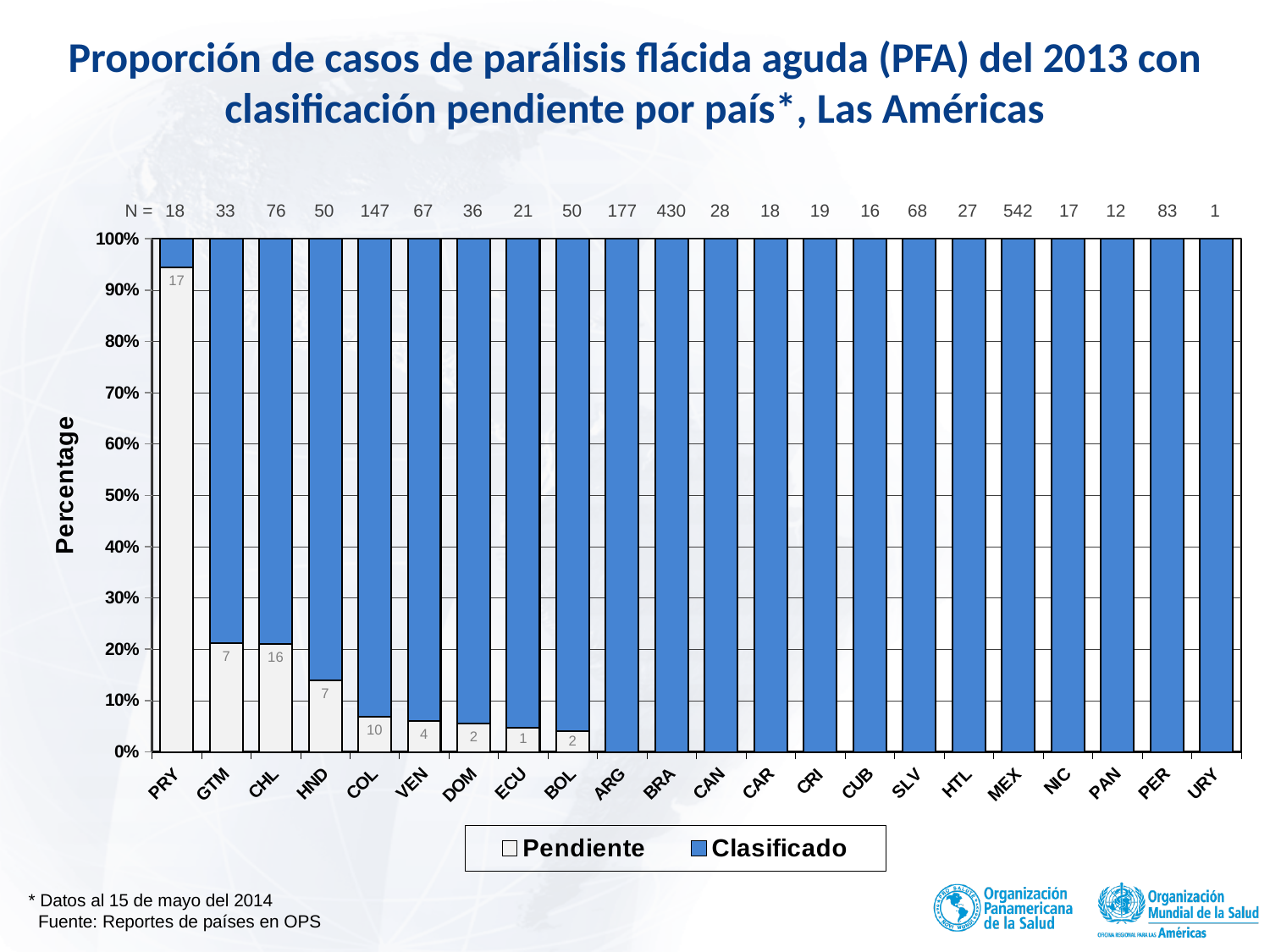
What is the N value shown above the bar for MEX? 542 How many series does the legend list? 2 What is the N value shown above the bar for BRA? 430 What kind of chart is shown on the slide? stacked bar chart What number is printed on the Pendiente segment for CHL? 16 Which series is shown in blue in the legend? Clasificado What number is printed on the Pendiente segment for PRY? 17 Which country has the largest Pendiente share of its bar? PRY Is the Pendiente share for PRY greater or less than 90%? greater What number is printed on the Pendiente segment for COL? 10 How many countries are shown along the x axis? 22 Is the Pendiente share for HND greater or less than 20%? less